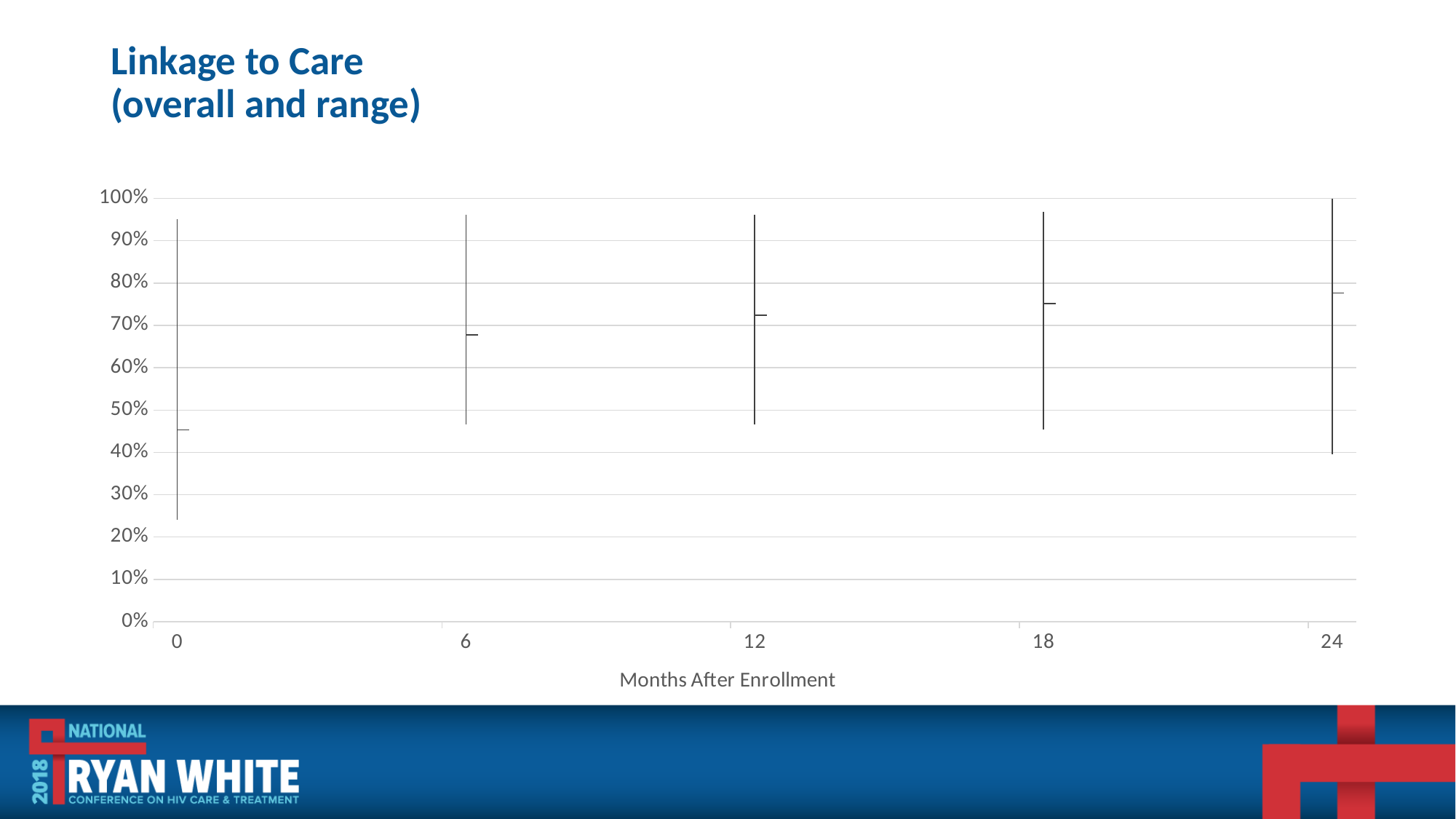
Is the overall linkage-to-care value at 6 months greater or less than 60%? greater What is the title of the chart on the slide? Linkage to Care (overall and range) Is the overall linkage-to-care value at 24 months greater or less than 70%? greater What is the label of the x axis? Months After Enrollment How many time points (months after enrollment) are plotted on the chart? 5 Does the overall linkage-to-care value rise or fall from 0 to 24 months after enrollment? rise Is the overall linkage-to-care value at 0 months greater or less than 50%? less At which month after enrollment is the overall linkage-to-care value lowest? 0 Is the overall value at 12 months larger or smaller than the overall value at 0 months? larger At which month after enrollment does the range reach its lowest minimum value? 0